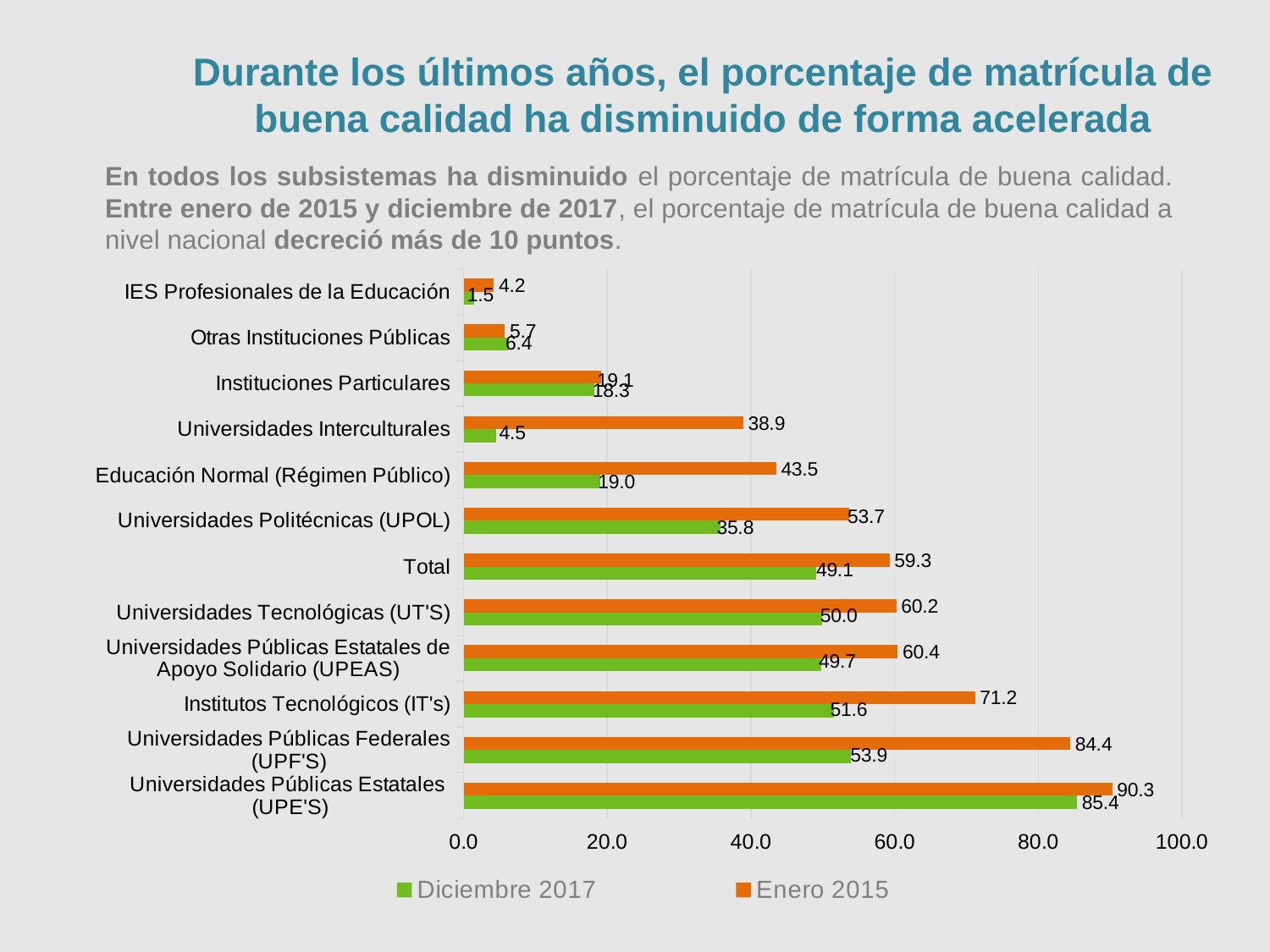
Which series is shown in green? Diciembre 2017 What is the difference between the Enero 2015 and Diciembre 2017 values for Institutos Tecnológicos (IT's)? 19.6 How many series does the legend list? 2 What is the difference between the Enero 2015 and Diciembre 2017 values for Total? 10.2 What is the Diciembre 2017 value for Total? 49.1 What is the Diciembre 2017 value for Universidades Públicas Federales (UPF'S)? 53.9 Which category has the highest Enero 2015 value? Universidades Públicas Estatales (UPE'S) What is the Enero 2015 value for Universidades Interculturales? 38.9 How many categories are plotted on the chart? 12 For Otras Instituciones Públicas, which is larger: the Enero 2015 value or the Diciembre 2017 value? Diciembre 2017 What kind of chart is shown on the slide? bar chart Which category has the lowest Diciembre 2017 value? IES Profesionales de la Educación